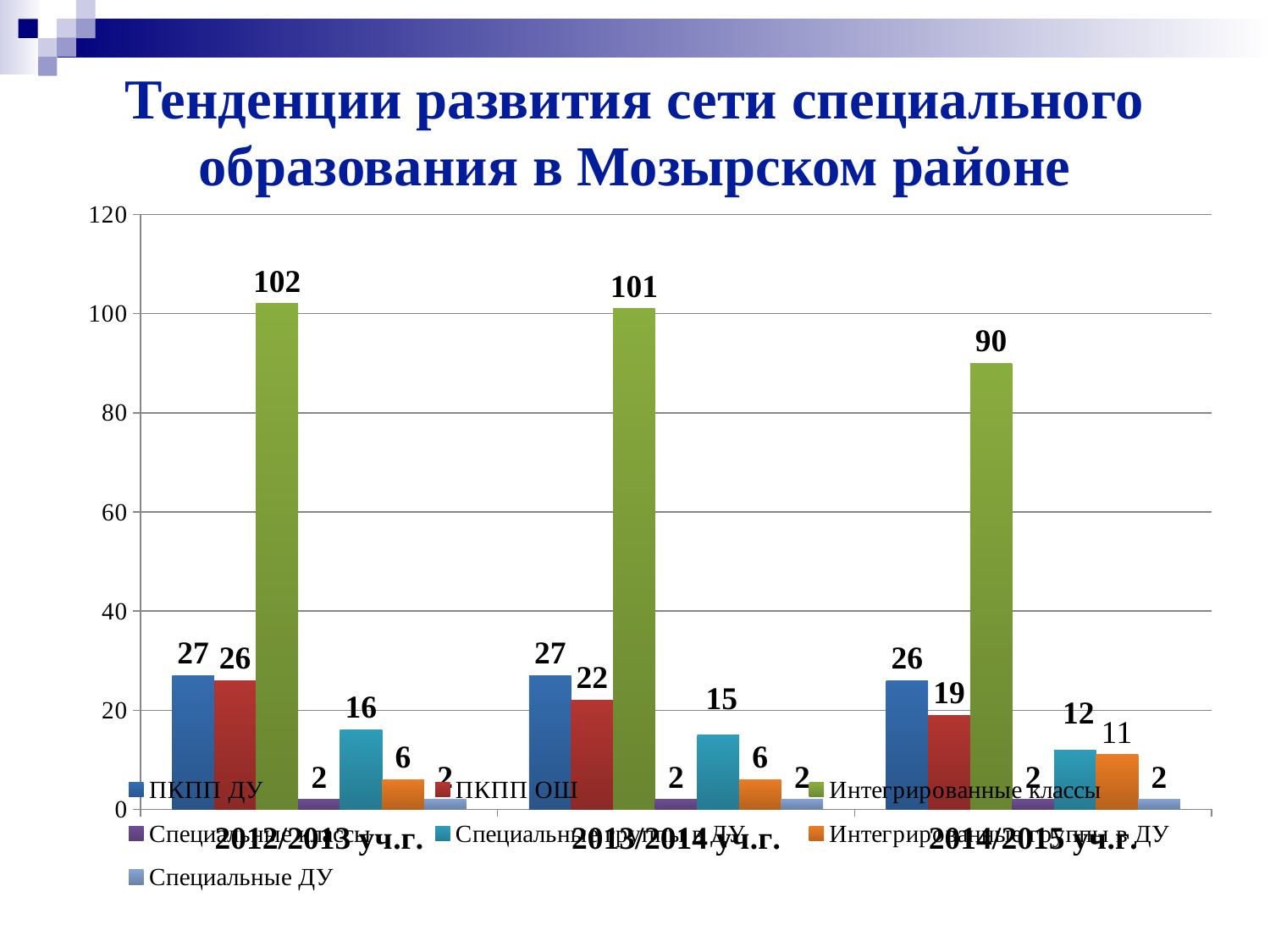
What is the title of the chart? Тенденции развития сети специального образования в Мозырском районе What is the value for ПКПП ДУ in 2013/2014 уч.г.? 27 Which series has the highest value in 2013/2014 уч.г.? Интегрированные классы What is the value for ПКПП ОШ in 2014/2015 уч.г.? 19 Does the value for ПКПП ОШ rise or fall across the school years from 2012/2013 to 2014/2015? fall What type of chart is shown on the slide? bar chart In which school year is the value for Интегрированные классы the lowest? 2014/2015 уч.г. How many series does the legend list? 7 What is the value for Интегрированные классы in 2012/2013 уч.г.? 102 What is the difference between the Интегрированные классы values for 2012/2013 уч.г. and 2014/2015 уч.г.? 12 How many school years (categories) are shown on the x axis? 3 Which is larger: ПКПП ОШ in 2012/2013 уч.г. or ПКПП ОШ in 2014/2015 уч.г.? ПКПП ОШ in 2012/2013 уч.г.